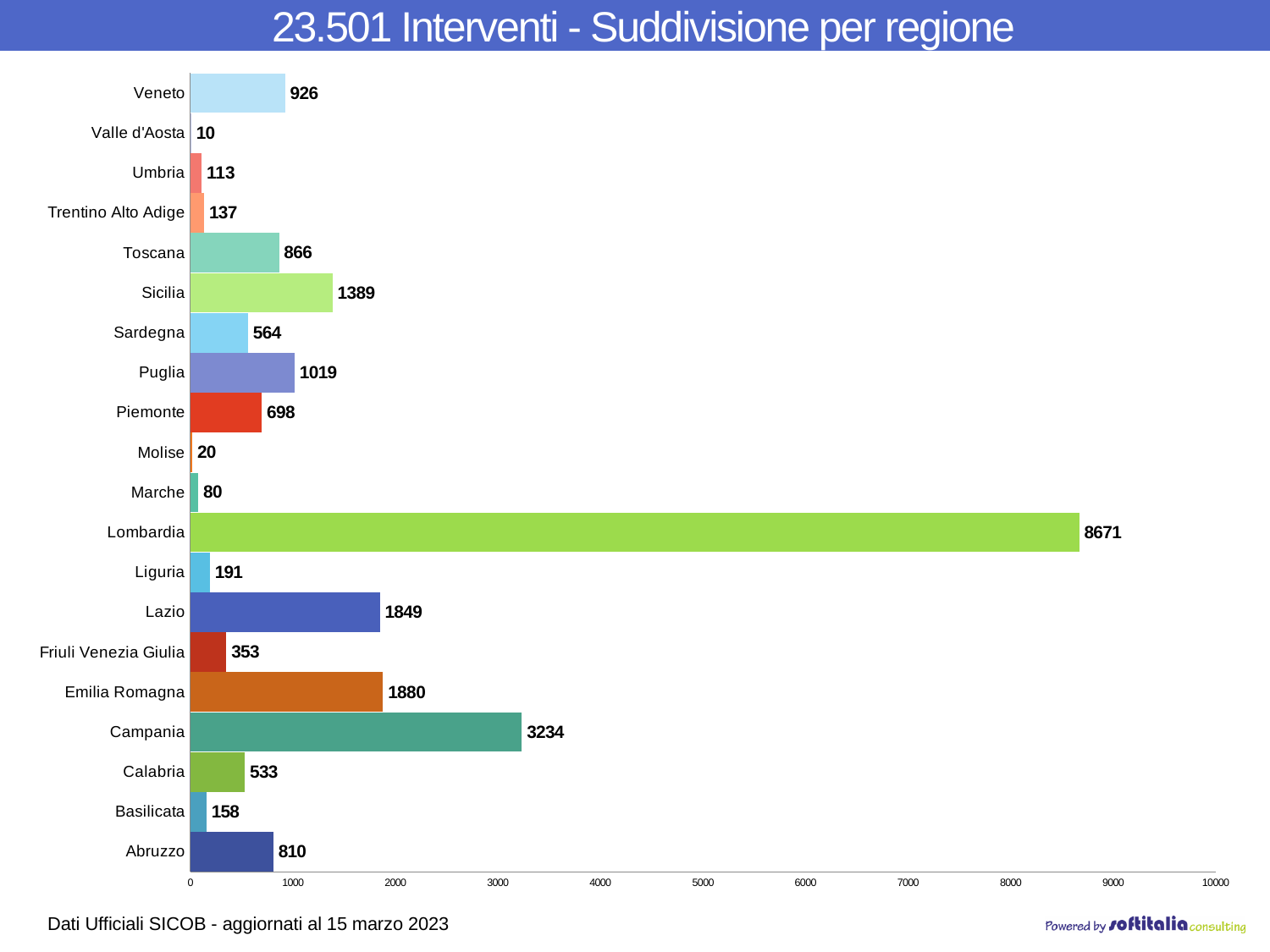
What kind of chart is shown on the slide? bar chart What is the title of the chart? 23.501 Interventi - Suddivisione per regione What is the value for Trentino Alto Adige? 137 Which region has the lowest value? Valle d'Aosta What is the value for Campania? 3234 Is the value for Campania greater or less than 3000? greater What is the difference between the values for Emilia Romagna and Lazio? 31 What is the difference between the values for Veneto and Toscana? 60 What is the value for Lombardia? 8671 Which region has the highest value? Lombardia Which is larger, the value for Sicilia or the value for Puglia? Sicilia How many regions are shown in the chart? 20